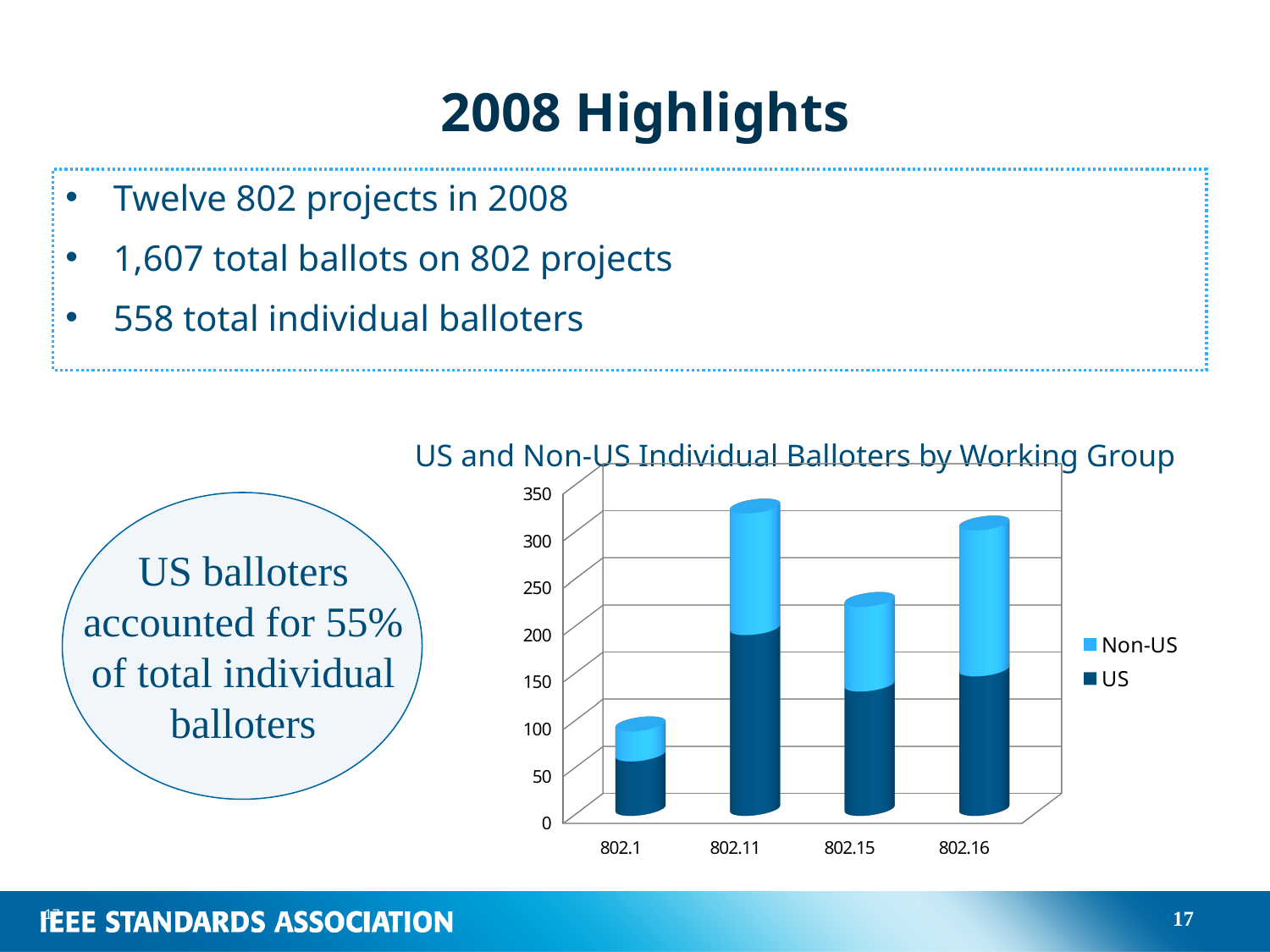
Is the total number of balloters for 802.1 greater or less than 150? less Is the total number of balloters for 802.16 greater or less than 250? greater Which series is shown in the darker blue colour in the chart? US What is the title of the chart? US and Non-US Individual Balloters by Working Group Is the total number of balloters for 802.15 greater or less than 200? greater Which working group has the lowest total number of individual balloters? 802.1 What kind of chart is shown on the slide? stacked bar chart How many series does the chart legend list? 2 Which working group has more total balloters, 802.11 or 802.15? 802.11 How many working groups are shown on the x axis of the chart? 4